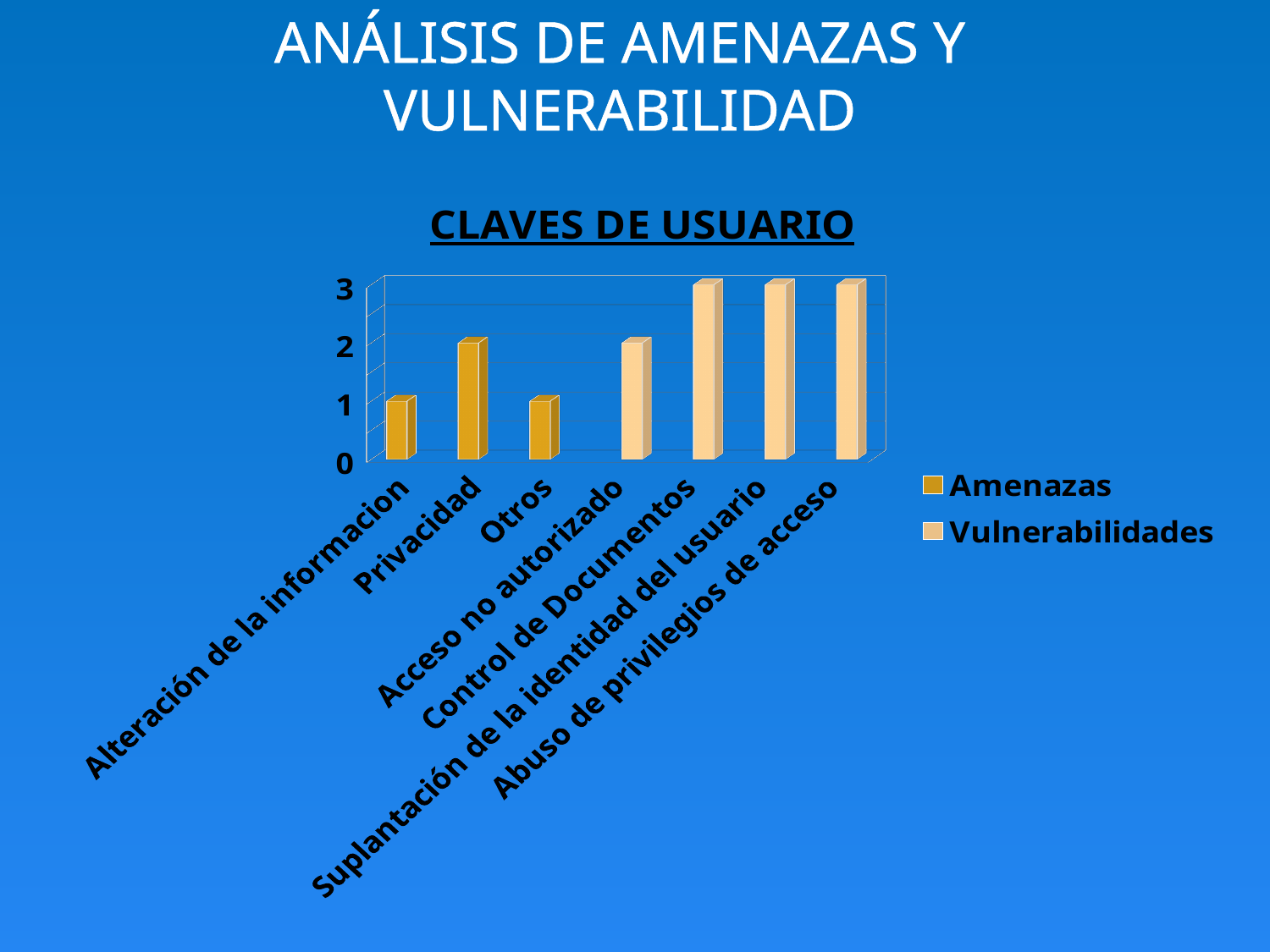
How many categories are shown on the x axis of the CLAVES DE USUARIO chart? 7 What is the value of the bar for Acceso no autorizado? 2 What is the value of the bar for Otros? 1 What is the value of the bar for Privacidad? 2 What kind of chart is shown under the title CLAVES DE USUARIO? bar chart Is the value for Suplantación de la identidad del usuario greater or less than 2? greater Which series does the bar for Alteración de la informacion belong to, according to the legend colours? Amenazas What are the two legend entries of the CLAVES DE USUARIO chart? Amenazas and Vulnerabilidades Which is larger, the bar for Privacidad or the bar for Otros? Privacidad How many series does the legend of the CLAVES DE USUARIO chart list? 2 What is the value of the bar for Control de Documentos? 3 What is the difference between the bar for Abuso de privilegios de acceso and the bar for Alteración de la informacion? 2